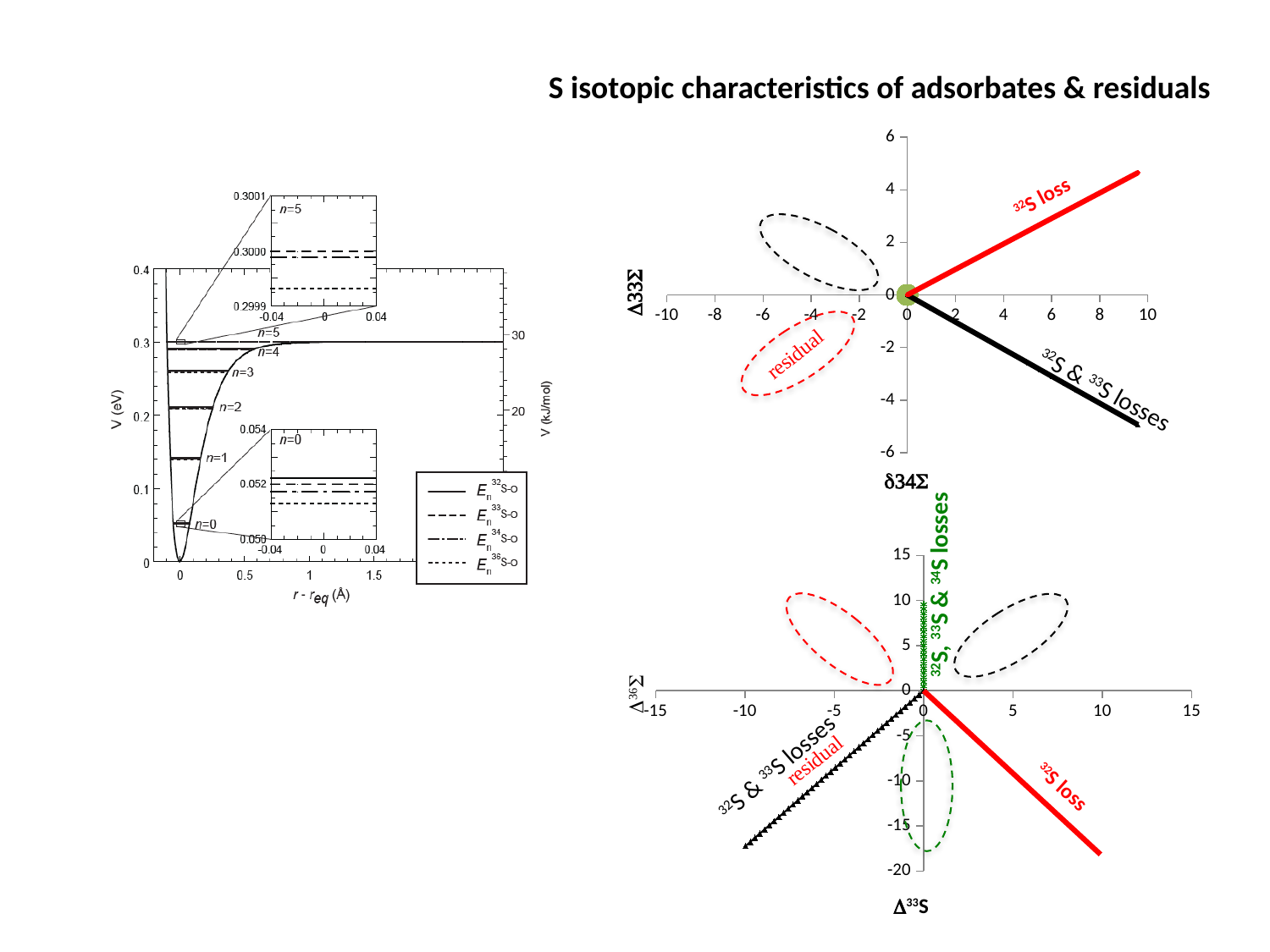
On the top-right chart (Δ33S vs δ34S), does the red '32S loss' line rise or fall as δ34S increases? rises On the top-right chart (Δ33S vs δ34S), does the black '32S & 33S losses' line rise or fall as δ34S increases? falls On the left-hand potential energy chart, which line style represents E_n for 36S-O in the legend? dotted On the left-hand potential energy chart, is the energy of the n=3 level greater or less than 0.2 eV? greater On the bottom-right chart (Δ36S vs Δ33S), does the red '32S loss' line rise or fall as Δ33S increases? falls On the top-right chart (Δ33S vs δ34S), is the Δ33S value at the right-hand end of the red '32S loss' line greater or less than 4? greater On the left-hand potential energy chart, is the energy of the n=0 level greater or less than 0.1 eV? less On the bottom-right chart (Δ36S vs Δ33S), what is the lowest value shown on the y axis? -20 How many vibrational energy levels (n values) are labelled on the left-hand potential energy chart? 6 What kind of chart is the left-hand chart showing V (eV) against r - r_eq (Å)? line chart How many series does the legend of the left-hand potential energy chart list? 4 On the top-right chart (Δ33S vs δ34S), what is the highest value shown on the x axis? 10